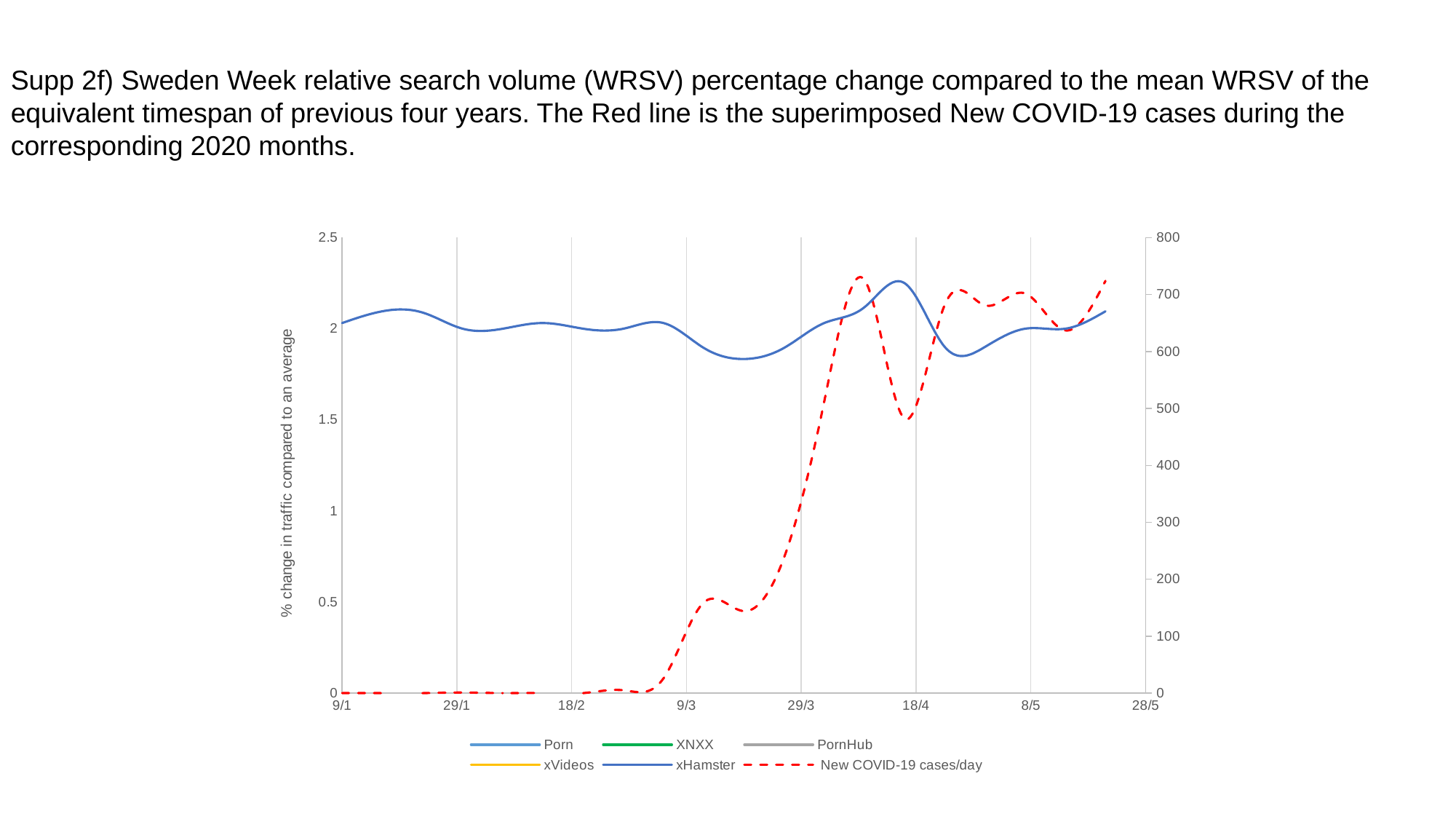
Is the value of the red dashed line (New COVID-19 cases/day) at 9/3 greater or less than 100 on the right axis? less Is the value of the solid blue line at 9/1 greater or less than 1.5 on the left axis? greater Is the value of the red dashed line (New COVID-19 cases/day) at 8/5 greater or less than 600 on the right axis? greater Does the red dashed line (New COVID-19 cases/day) rise or fall between 9/3 and 29/3? rise How many series does the legend list? 6 How many date labels are shown along the x axis? 8 What kind of chart is shown on the slide? line chart What is the label of the left vertical axis? % change in traffic compared to an average Between which two x-axis labels does the solid blue line reach its highest point? between 29/3 and 18/4 Which series is drawn as the red dashed line? New COVID-19 cases/day